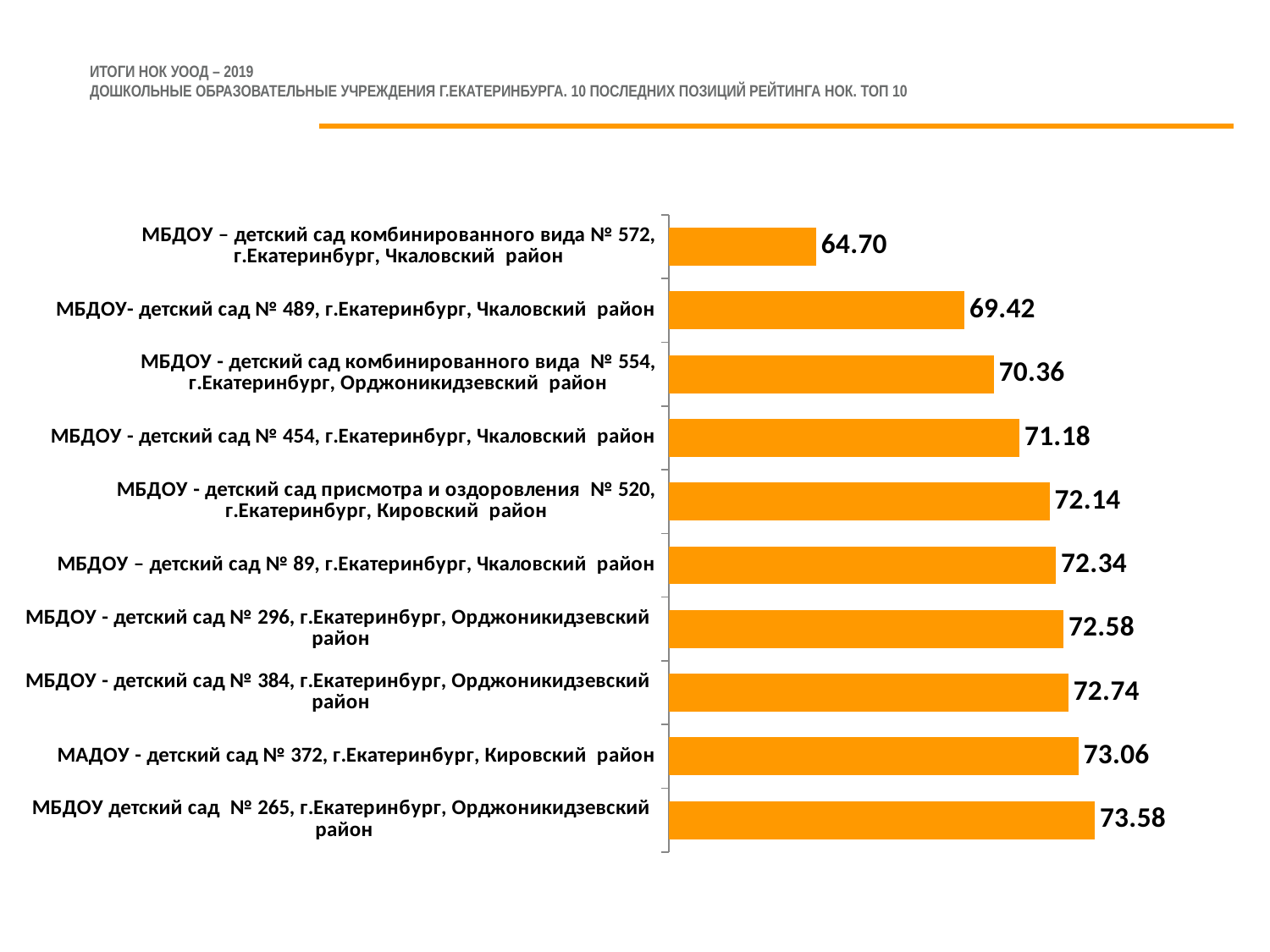
What value is shown for МБДОУ - детский сад № 454, г.Екатеринбург, Чкаловский район? 71.18 What value is shown for МБДОУ - детский сад № 384, г.Екатеринбург, Орджоникидзевский район? 72.74 Which institution has the lowest value on the chart? МБДОУ – детский сад комбинированного вида № 572, г.Екатеринбург, Чкаловский район What is the difference between the values for МБДОУ детский сад № 265 (Орджоникидзевский район) and МБДОУ – детский сад комбинированного вида № 572 (Чкаловский район)? 8.88 How many institutions are shown on the chart? 10 Which institution has the highest value on the chart? МБДОУ детский сад № 265, г.Екатеринбург, Орджоникидзевский район What colour are the bars on the chart? Orange Which has a larger value: МБДОУ - детский сад присмотра и оздоровления № 520 or МБДОУ - детский сад № 454? МБДОУ - детский сад присмотра и оздоровления № 520 What value is shown for МАДОУ - детский сад № 372, г.Екатеринбург, Кировский район? 73.06 What is the difference between the values for МБДОУ- детский сад № 489 and МБДОУ - детский сад комбинированного вида № 554? 0.94 What kind of chart is shown on the slide? Bar chart What value is shown for МБДОУ – детский сад комбинированного вида № 572, г.Екатеринбург, Чкаловский район? 64.70